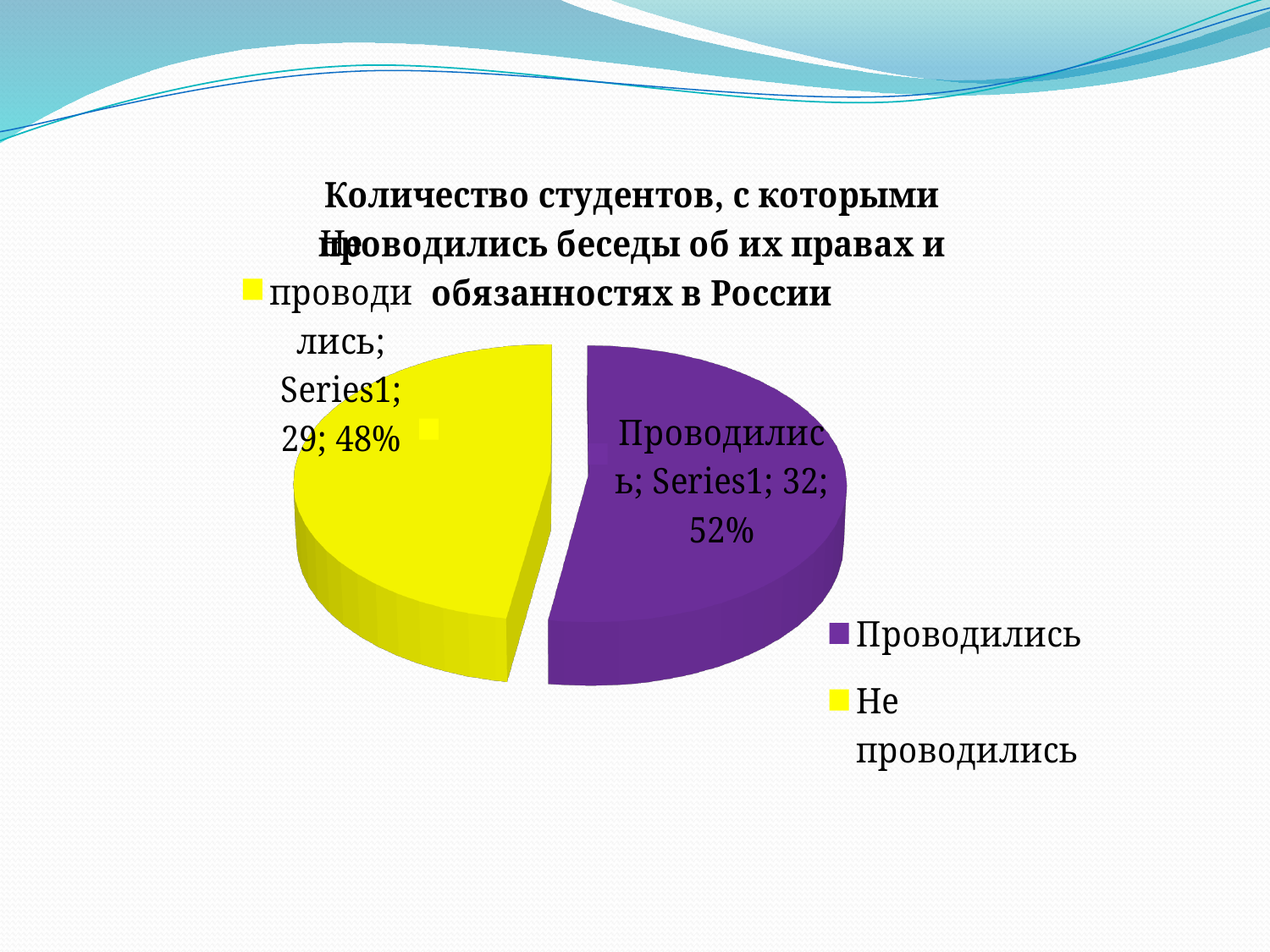
Which is larger, the value for "Проводились" or the value for "Не проводились"? Проводились What colour is the slice for "Не проводились"? yellow What percentage share of the pie does "Не проводились" have? 48% What is the value for "Не проводились"? 29 What is the total of the two values shown in the pie chart? 61 Which category has the smallest slice of the pie? Не проводились What kind of chart is shown on the slide? pie chart Which category has the largest slice of the pie? Проводились What is the value for "Проводились"? 32 What is the difference between the values for "Проводились" and "Не проводились"? 3 How many slices does the pie chart have? 2 What percentage share of the pie does "Проводились" have? 52%